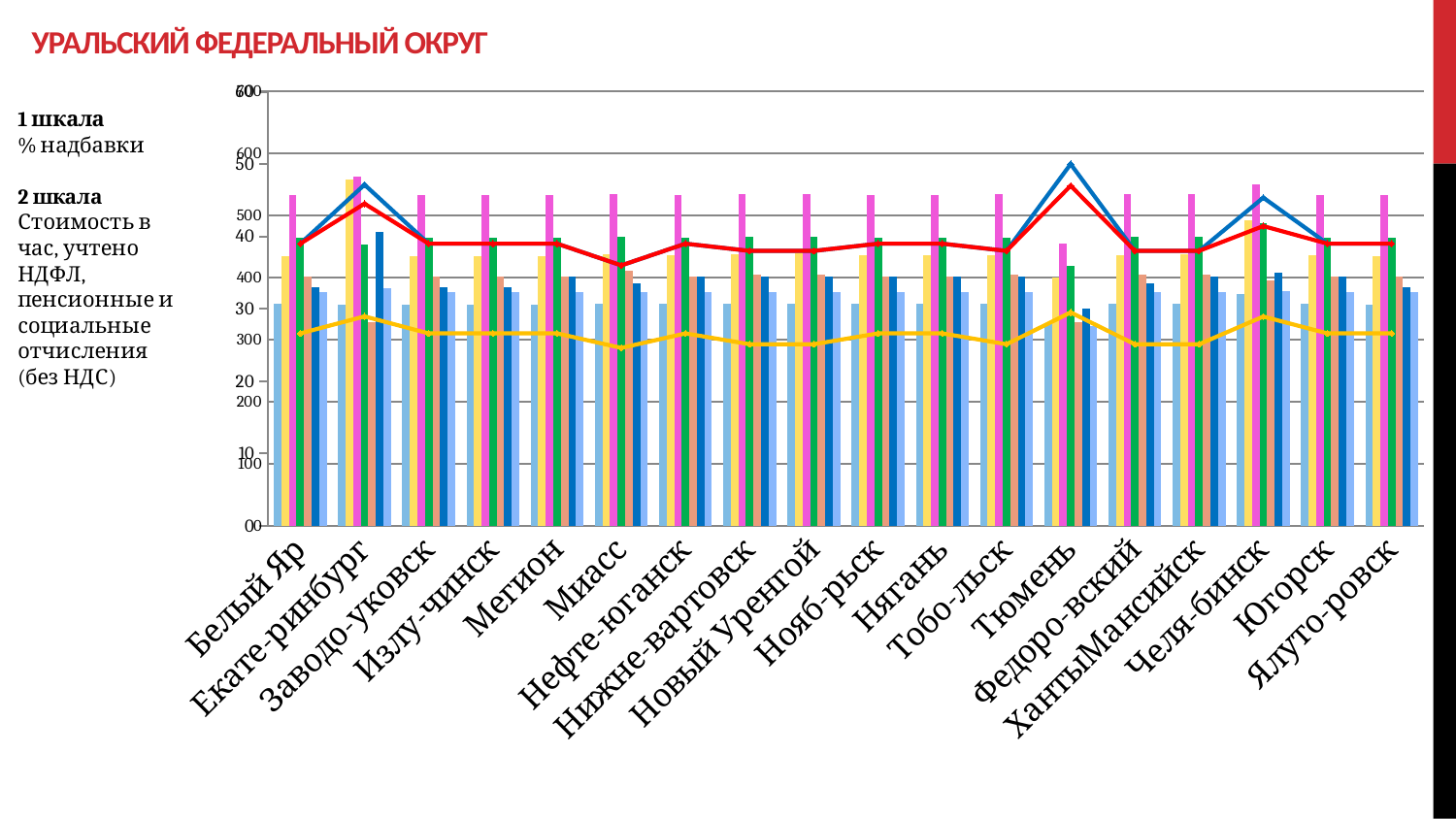
Is the pink bar for Белый Яр greater or less than 500 on the left axis? greater For which category does the red line reach its highest point? Тюмень For which category is the yellow bar the tallest? Екатеринбург Which category is the first one on the x axis of the chart? Белый Яр How many categories (cities) are shown along the x axis of the chart? 18 Which is taller for Екатеринбург, the yellow bar or the light blue bar? the yellow bar Which is higher for Тюмень, the blue line or the yellow line? the blue line For which category is the pink (magenta) bar the shortest? Тюмень Is the yellow bar for Екатеринбург greater or less than 500 on the left axis? greater What is the title of the slide containing the chart? УРАЛЬСКИЙ ФЕДЕРАЛЬНЫЙ ОКРУГ What kind of chart is shown on the slide? Combined bar and line chart For which category does the blue line reach its highest point? Тюмень